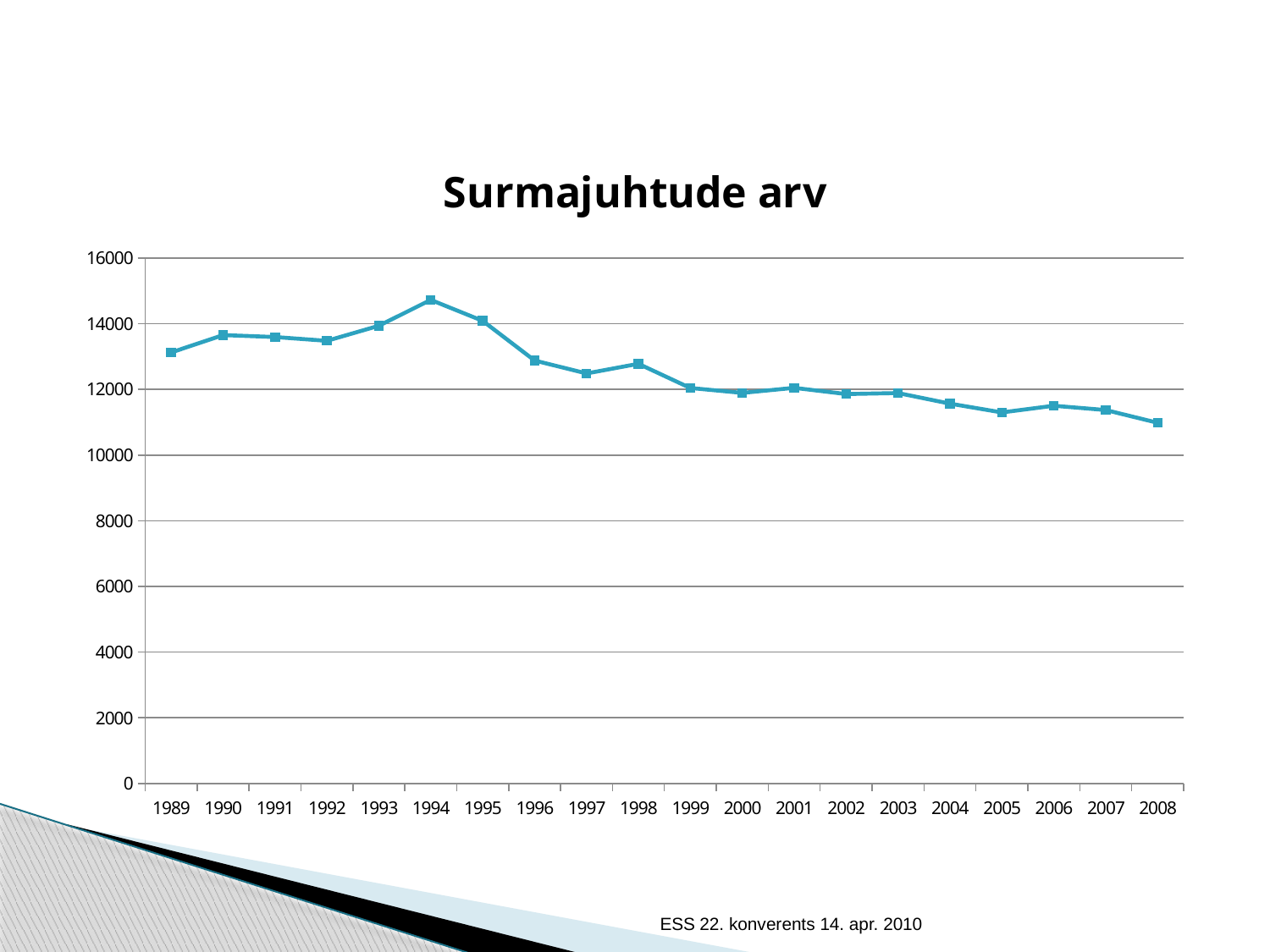
Which year has the larger value, 1994 or 2008? 1994 Is the value for 2005 greater or less than 12000? less What kind of chart is shown on the slide? line chart Is the value for 1989 greater or less than 12000? greater Which year has the larger value, 1990 or 1996? 1990 Is the value for 2008 greater or less than 12000? less Which year has the highest value in the chart? 1994 Which year has the lowest value in the chart? 2008 Do the values generally rise or fall from 1994 to 2008? fall What is the title of the chart? Surmajuhtude arv How many years are plotted on the x axis of the chart? 20